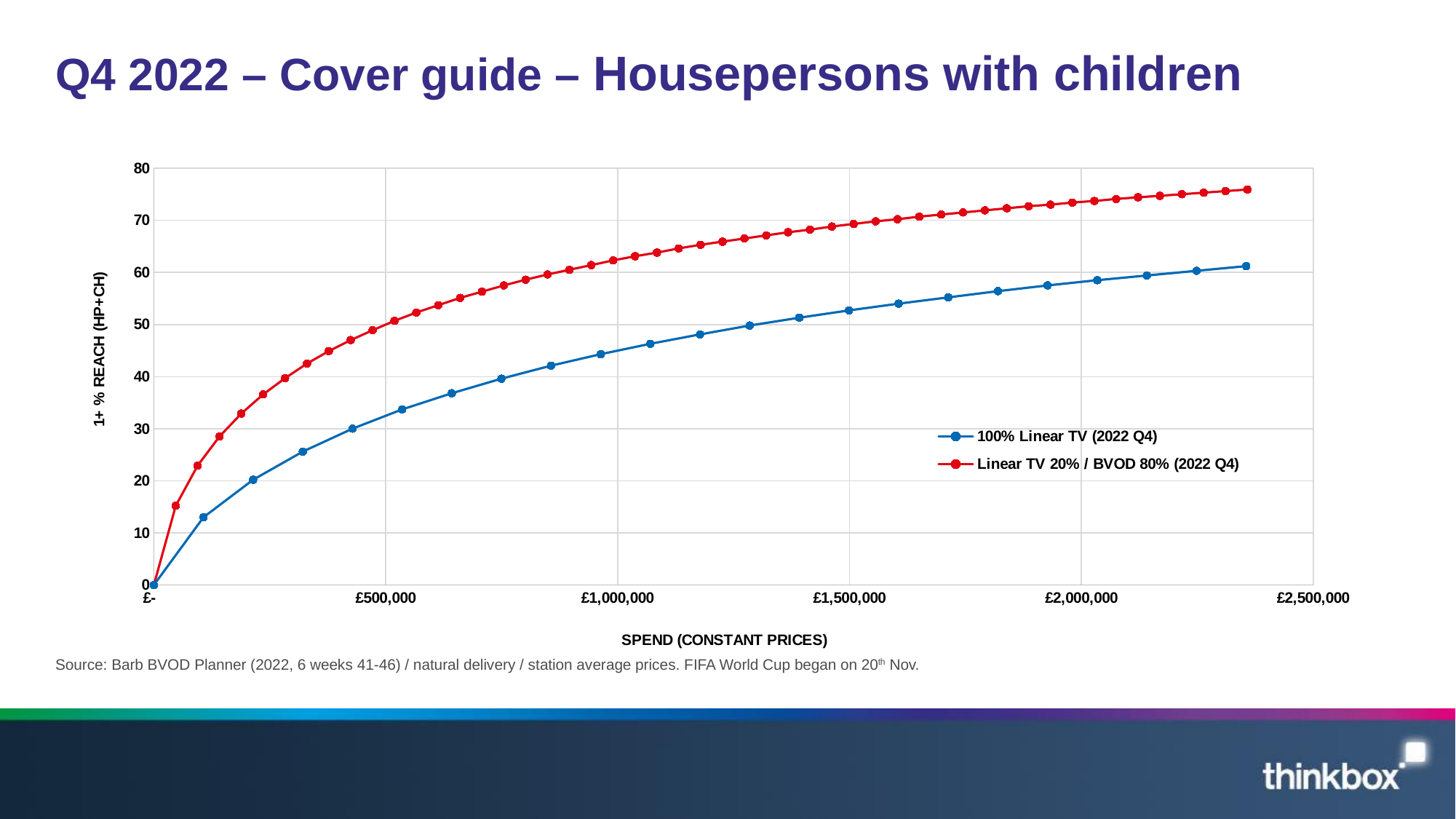
Is the 1+ % reach for Linear TV 20% / BVOD 80% (2022 Q4) at a spend of £2,000,000 greater or less than 70? greater Does the 1+ % reach for 100% Linear TV (2022 Q4) rise or fall as spend increases? Rise What kind of chart is shown on the slide? Line chart How many series does the legend list? 2 Which colour is used for the Linear TV 20% / BVOD 80% (2022 Q4) series? Red Is the 1+ % reach for 100% Linear TV (2022 Q4) at a spend of £2,000,000 greater or less than 60? less At a spend of £1,000,000, which series has the higher 1+ % reach: 100% Linear TV (2022 Q4) or Linear TV 20% / BVOD 80% (2022 Q4)? Linear TV 20% / BVOD 80% (2022 Q4) What is the 1+ % reach for both series at a spend of £-? 0 Is the 1+ % reach for Linear TV 20% / BVOD 80% (2022 Q4) at a spend of £1,000,000 greater or less than 60? greater Which series reaches a higher 1+ % reach at the right-hand end of the chart? Linear TV 20% / BVOD 80% (2022 Q4) What is the title of the x axis? SPEND (CONSTANT PRICES)